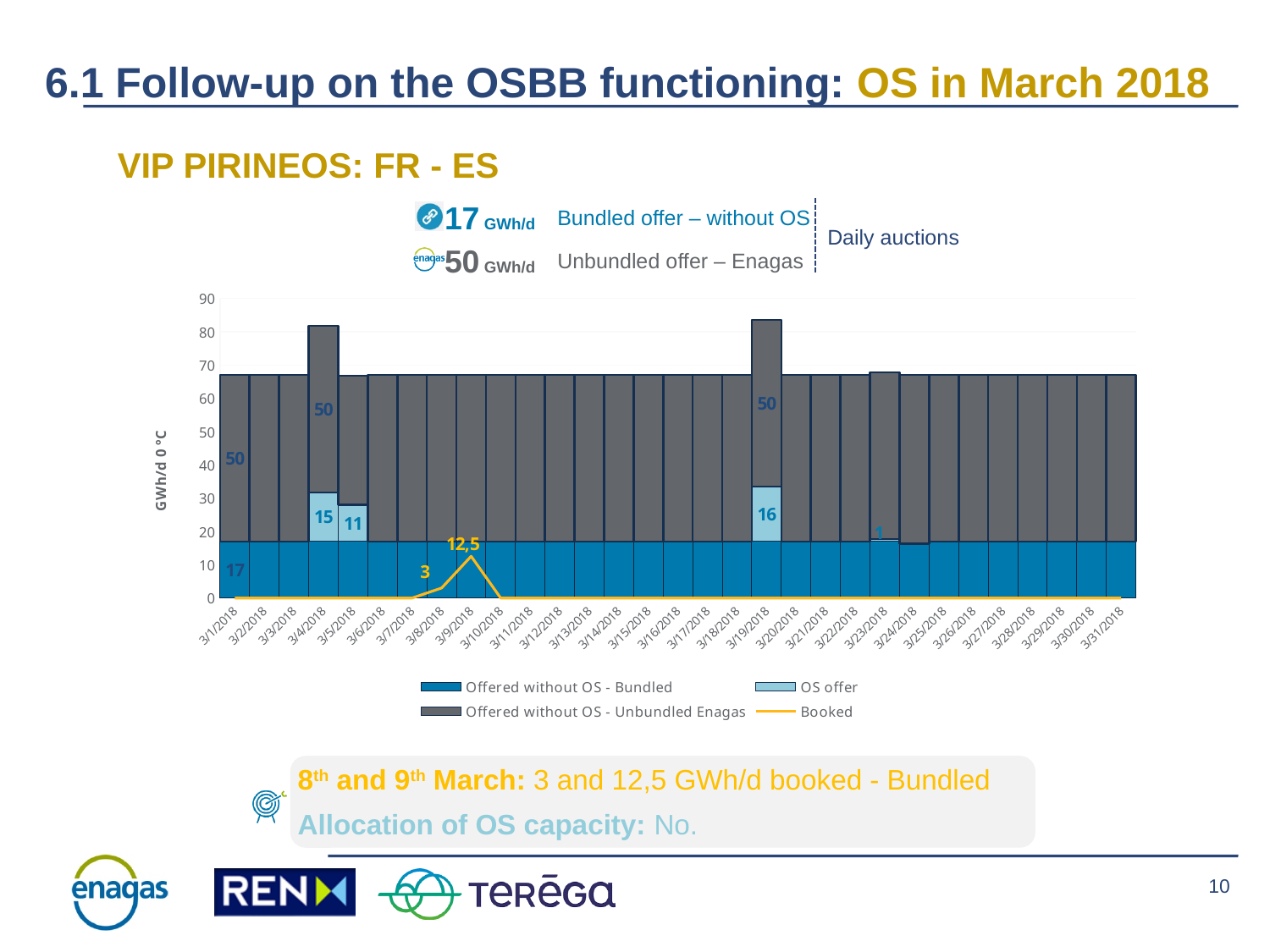
Is the total height of the stacked bar on 3/19/2018 greater or less than 70? greater Which date has the larger OS offer, 3/19/2018 or 3/5/2018? 3/19/2018 What is the OS offer value on 3/5/2018? 11 What is the OS offer value on 3/19/2018? 16 What is the Booked value on 3/8/2018? 3 How many dates are shown on the x axis of the chart? 31 How many series does the chart legend list? 4 What is the OS offer value on 3/4/2018? 15 What is the Booked value on 3/9/2018? 12,5 What kind of chart is shown on the slide? combination bar and line chart What is the difference between the OS offer on 3/4/2018 and on 3/5/2018? 4 What is the Offered without OS - Bundled value on 3/1/2018? 17